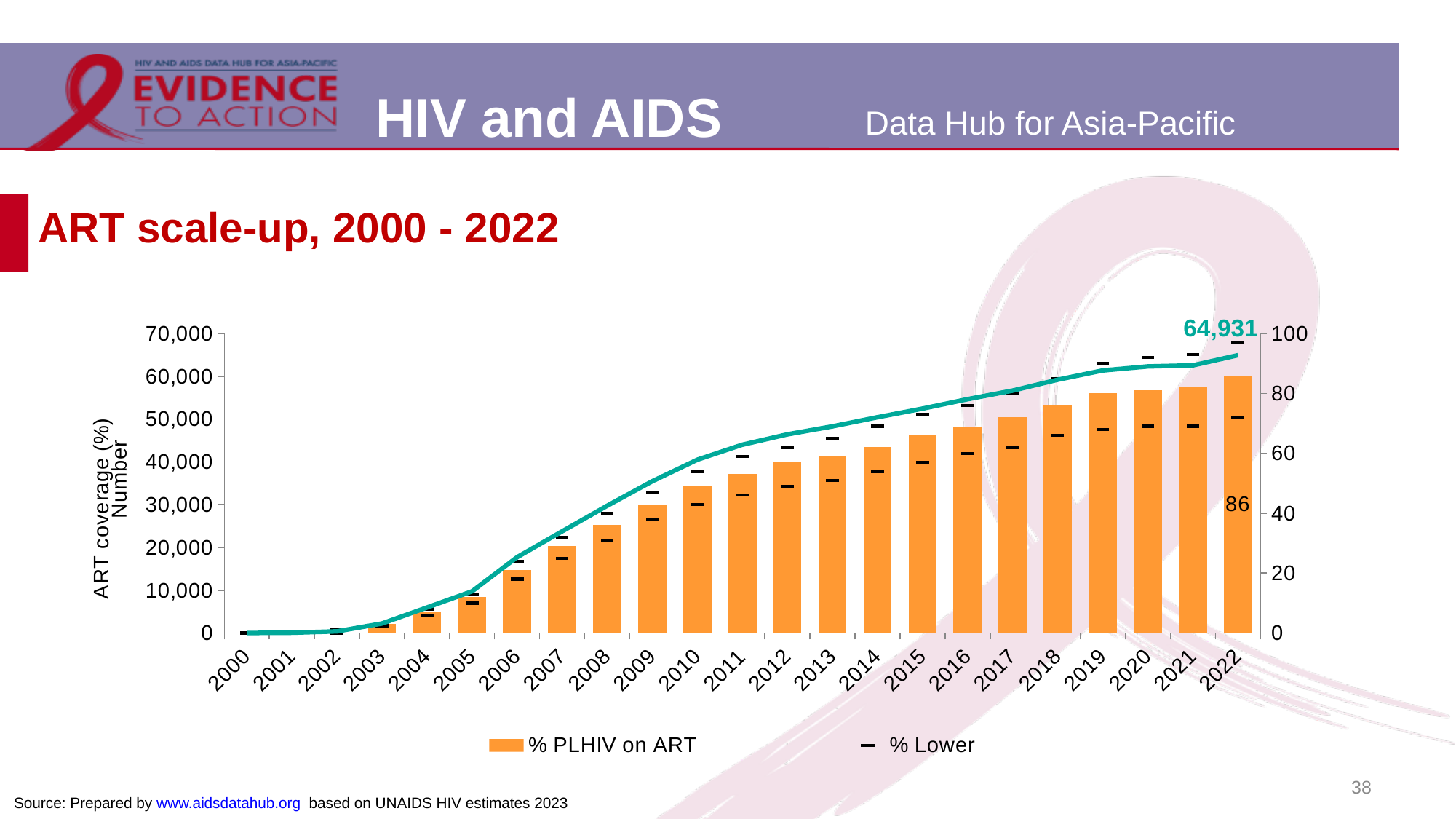
How many series does the legend list? 2 Is the line value for 2010 greater or less than 30,000? greater Do the % PLHIV on ART bars generally rise or fall from 2000 to 2022? rise Which year has the larger % PLHIV on ART bar, 2010 or 2015? 2015 Is the % PLHIV on ART bar for 2005 greater or less than 20? less How many years are shown on the x axis? 23 Which year has the highest % PLHIV on ART bar? 2022 What number is labelled on the line for 2022? 64,931 What is the title of the chart? ART scale-up, 2000 - 2022 What is the % PLHIV on ART value labelled for 2022? 86 Is the % PLHIV on ART bar for 2010 greater or less than 40? greater What are the two entries listed in the legend? % PLHIV on ART and % Lower